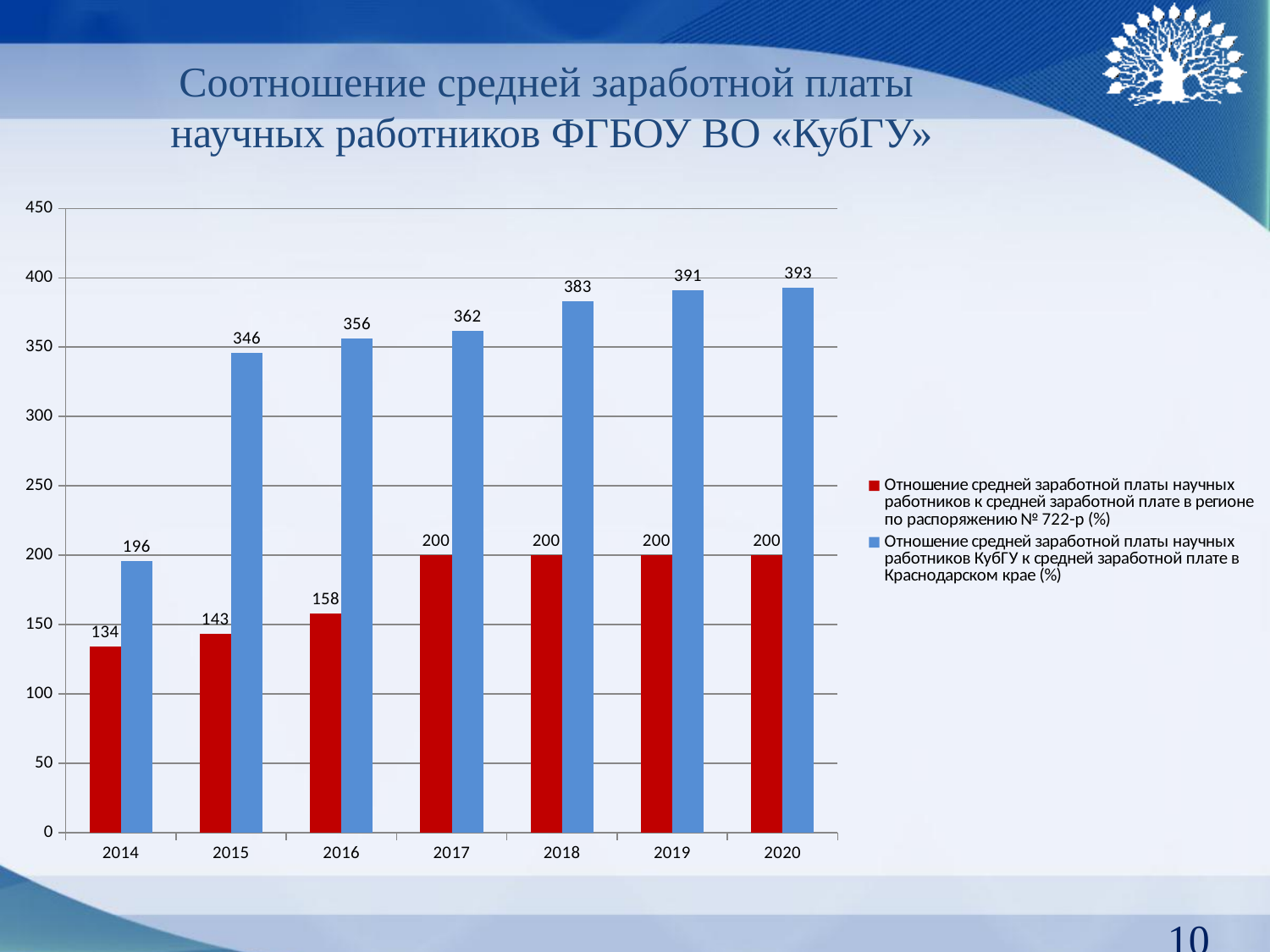
In which year is the blue series (KubGU ratio) lowest? 2014 Does the blue series rise or fall from 2014 to 2020? rise What is the value of the blue series (KubGU ratio to Krasnodar region average salary) for 2020? 393 What is the value of the blue series for 2015? 346 What is the difference between the blue and red values for 2018? 183 What kind of chart is shown on the slide? bar chart What is the difference between the blue values for 2015 and 2014? 150 In which year is the blue series (KubGU ratio) highest? 2020 How many years are shown on the x axis? 7 Which is larger in 2016: the red series value or the blue series value? the blue series (356) What is the value of the red series (ratio per order No. 722-r) for 2014? 134 How many series does the legend list? 2